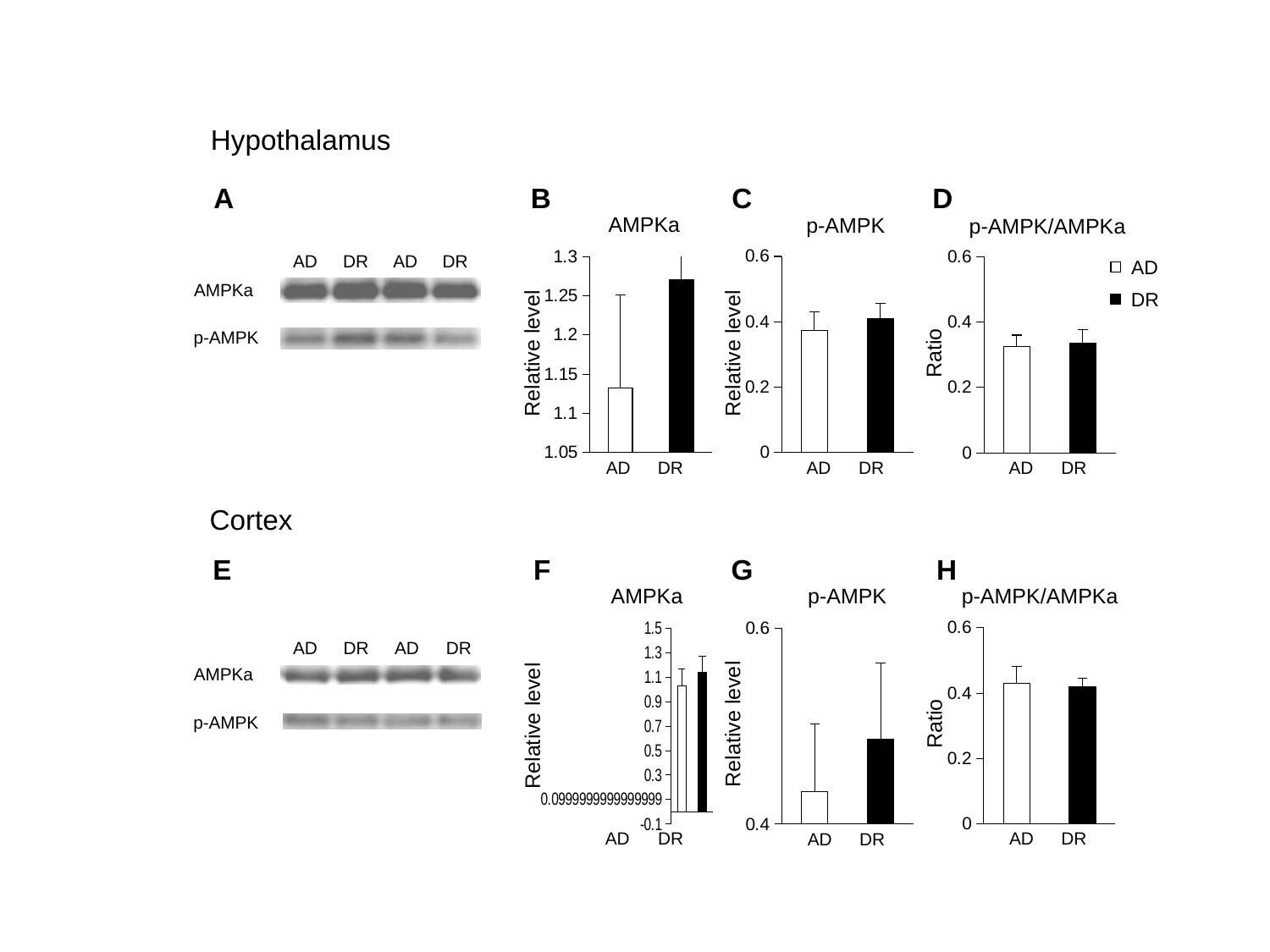
How many series does the legend in chart D list? 2 How many categories are shown on the x axis of chart H (Cortex p-AMPK/AMPKa)? 2 What is the y-axis label of chart D (Hypothalamus p-AMPK/AMPKa)? Ratio In chart G (Cortex p-AMPK), which bar is taller, AD or DR? DR In chart F (Cortex AMPKa), which bar is taller, AD or DR? DR In chart B (Hypothalamus AMPKa), is the value for DR greater or less than 1.2? greater In chart C (Hypothalamus p-AMPK), is the value for AD greater or less than 0.2? greater What kind of chart is chart B (Hypothalamus AMPKa)? bar chart In chart D (Hypothalamus p-AMPK/AMPKa), is the value for DR greater or less than 0.4? less In chart B (Hypothalamus AMPKa), which bar is taller, AD or DR? DR